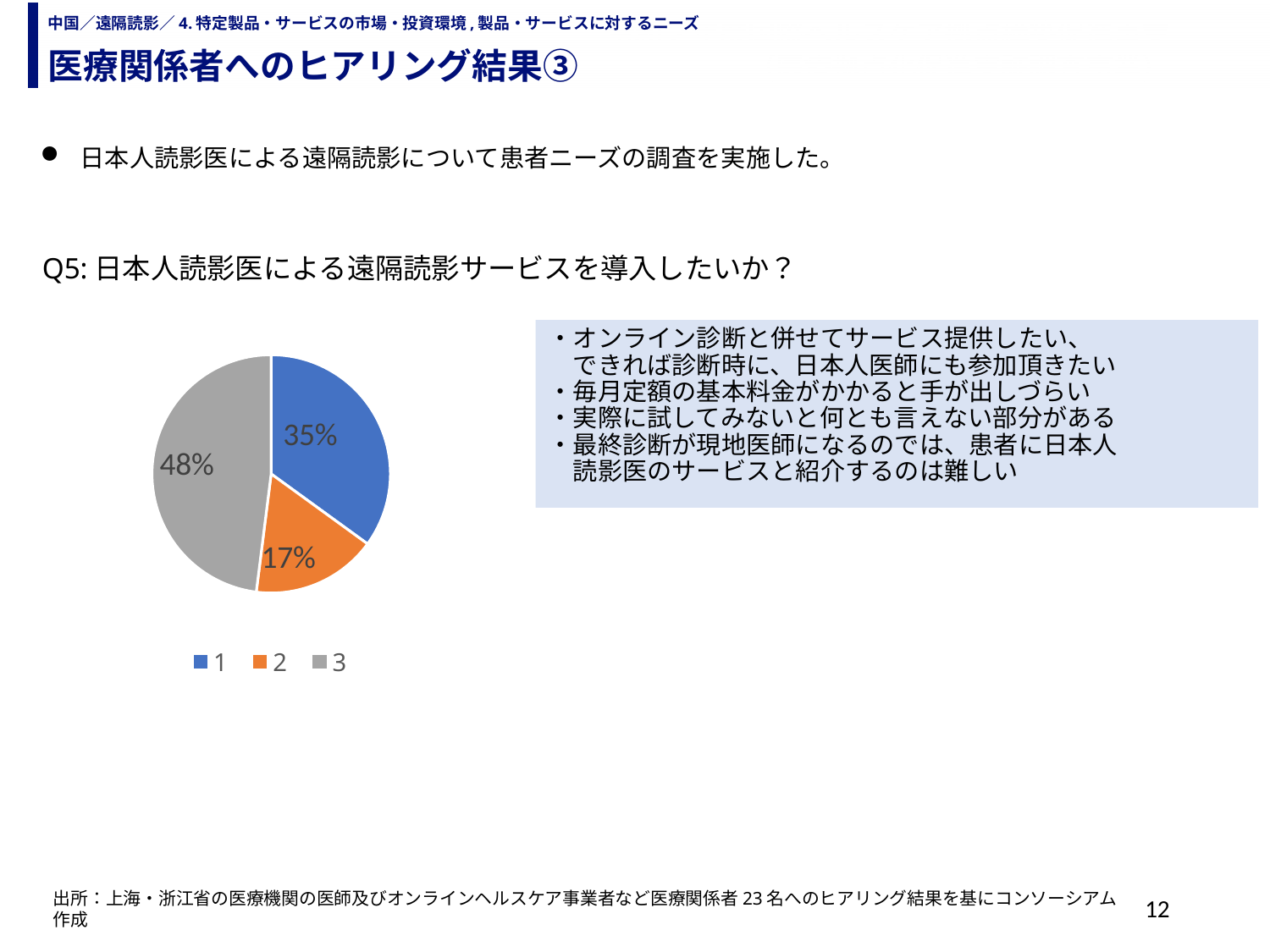
What colour is the slice for category 2? orange Which category has the smallest slice of the pie? 2 How many slices does the pie chart have? 3 What is the difference in percentage points between category 1 and category 2? 18 What kind of chart is shown on the slide? pie chart Which category has the largest slice of the pie? 3 Which is larger, the slice for category 1 or the slice for category 2? 1 What is the difference in percentage points between category 3 and category 1? 13 What share of the pie does category 3 represent? 48% What share of the pie does category 2 represent? 17% How many entries does the legend list? 3 What share of the pie does category 1 represent? 35%